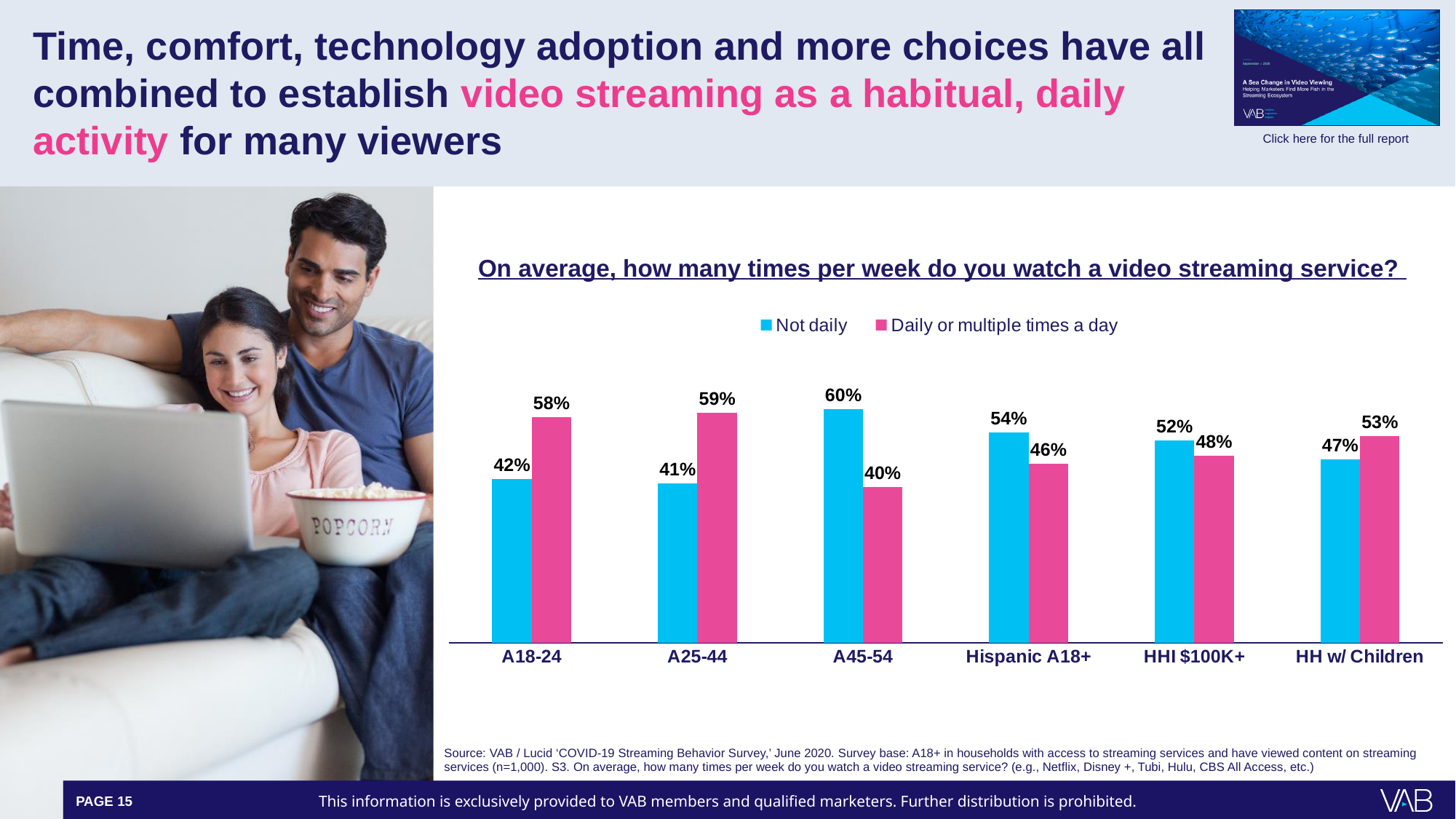
How many categories are shown on the x axis? 6 What is the 'Daily or multiple times a day' value for HH w/ Children? 53% Which category has the lowest 'Not daily' value? A25-44 What kind of chart is shown on the slide? Bar chart What is the 'Daily or multiple times a day' value for A18-24? 58% How many series does the legend list? 2 What is the difference between the 'Not daily' and 'Daily or multiple times a day' values for A45-54? 20% What colour represents the 'Daily or multiple times a day' series? Pink What is the 'Not daily' value for A45-54? 60% Which category has the highest 'Daily or multiple times a day' value? A25-44 What is the 'Not daily' value for HHI $100K+? 52% For Hispanic A18+, which is larger: 'Not daily' or 'Daily or multiple times a day'? Not daily